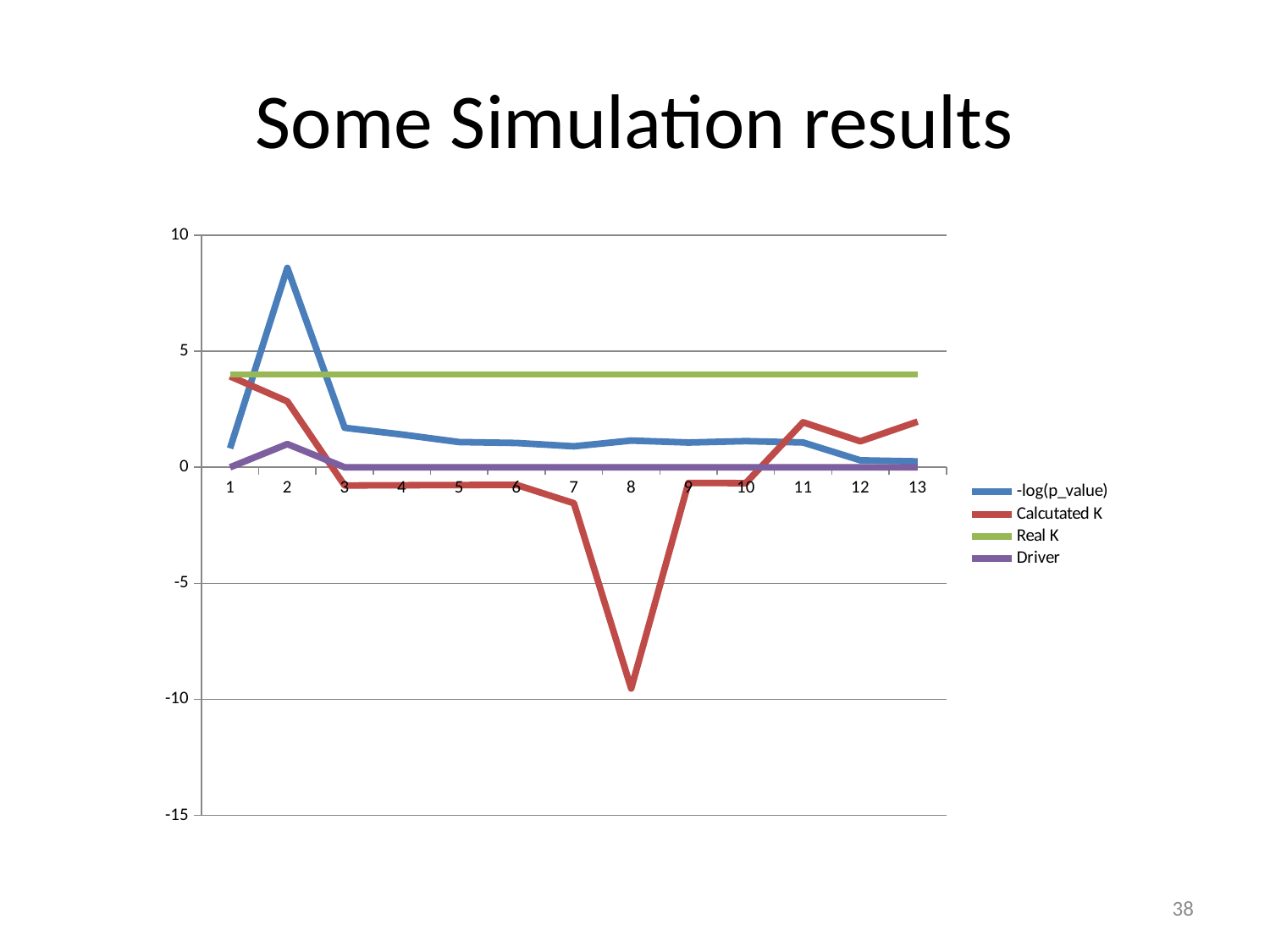
How many points are plotted along the x axis for each series? 13 Is the value of -log(p_value) at x = 2 greater or less than 5? greater At which x value does the -log(p_value) series reach its highest point? 2 What kind of chart is shown on the slide? line chart Is the value of Real K greater or less than 5? less What is the title of the slide containing the chart? Some Simulation results How many series does the legend list? 4 Does the Real K series rise, fall, or stay flat across the x axis? stays flat Is the value of Calcutated K at x = 8 greater or less than -5? less At x = 1, which series has the higher value, Real K or -log(p_value)? Real K At x = 2, which series has the higher value, -log(p_value) or Calcutated K? -log(p_value) At which x value does the Calcutated K series reach its lowest point? 8